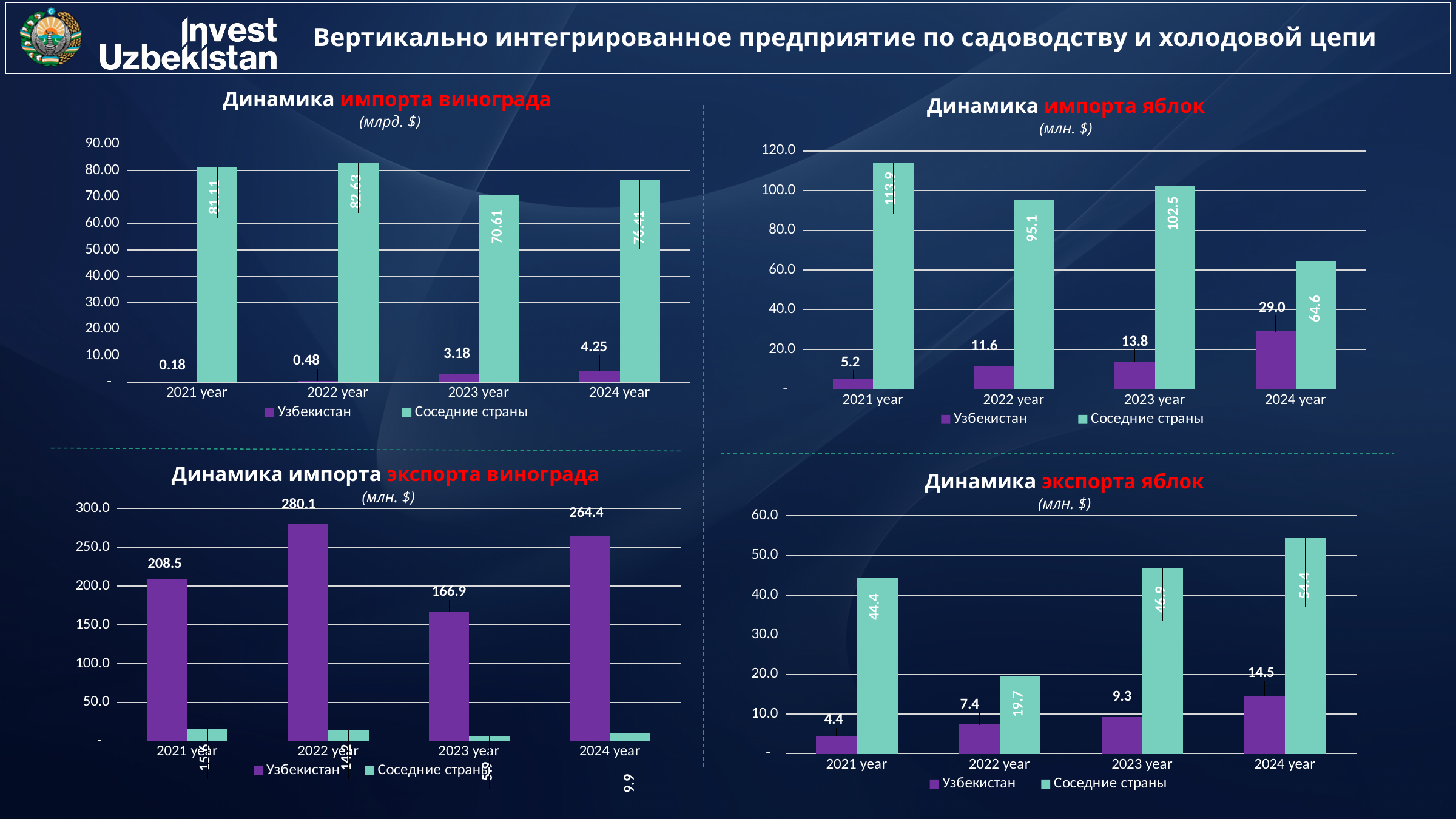
In the chart 'Динамика импорта винограда', which year has the lowest value for Соседние страны? 2023 year How many series does the legend of the chart 'Динамика экспорта яблок' list? 2 In the chart 'Динамика импорта винограда', do the values for Узбекистан rise or fall from 2021 year to 2024 year? rise In the chart 'Динамика импорта яблок', which year has the highest value for Соседние страны? 2021 year In the chart 'Динамика экспорта яблок', which is larger in 2022 year: Узбекистан or Соседние страны? Соседние страны In the chart 'Динамика импорта винограда', what is the value for Соседние страны in 2022 year? 82.63 In the chart 'Динамика импорта экспорта винограда', which year has the lowest value for Узбекистан? 2023 year In the chart 'Динамика экспорта яблок', what is the value for Соседние страны in 2024 year? 54.4 In the chart 'Динамика импорта яблок', what is the value for Узбекистан in 2024 year? 29.0 In the chart 'Динамика импорта экспорта винограда', what is the value for Узбекистан in 2022 year? 280.1 In the chart 'Динамика импорта яблок', what is the difference between Соседние страны and Узбекистан in 2023 year? 88.7 In the chart 'Динамика импорта винограда', what is the value for Узбекистан in 2024 year? 4.25